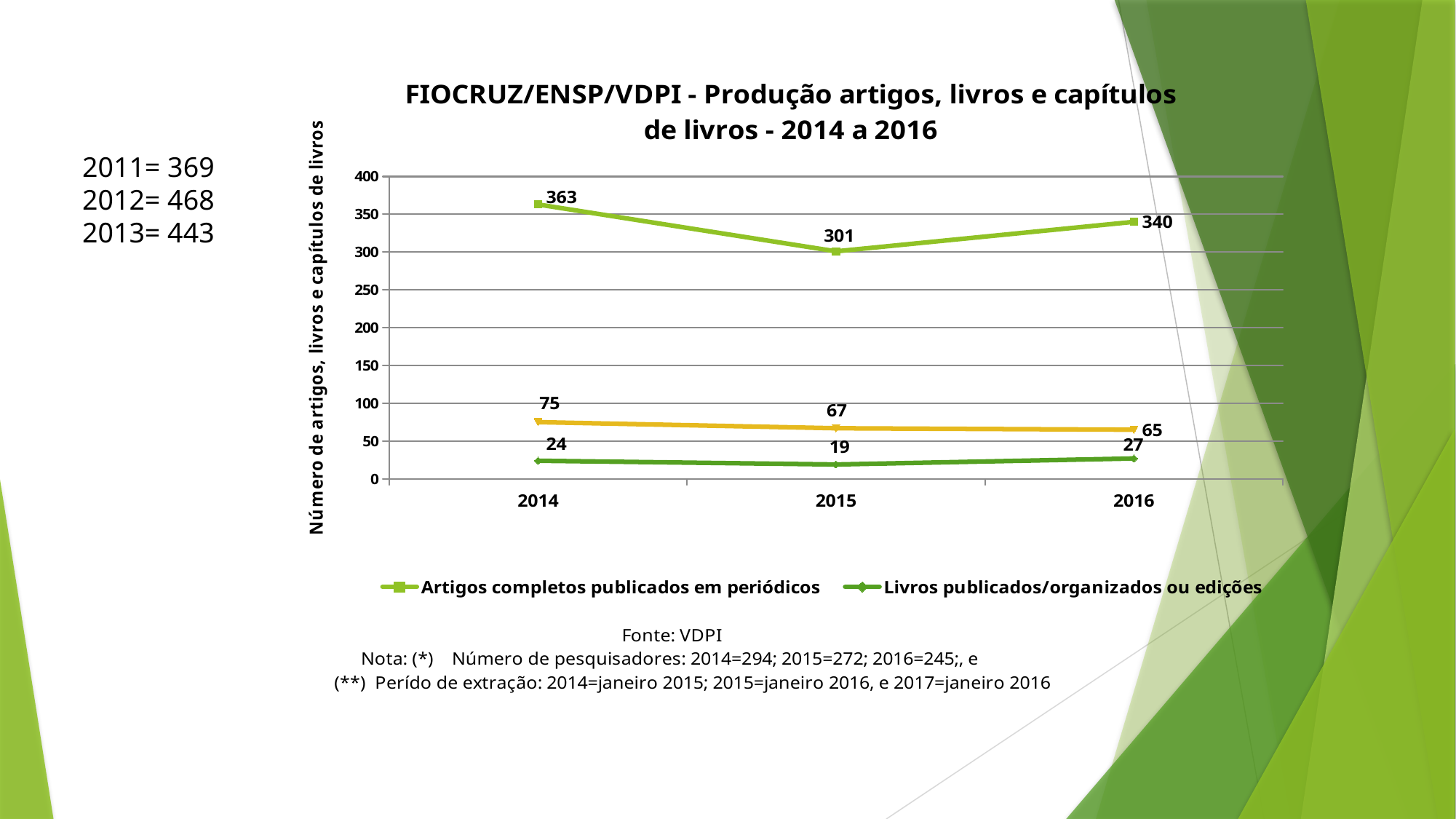
Does the value for Livros publicados/organizados ou edições rise or fall from 2014 to 2015? Fall How many series does the legend list? 2 How many years are shown on the x axis? 3 What is the value for Artigos completos publicados em periódicos in 2014? 363 Which year has the larger value for Artigos completos publicados em periódicos, 2014 or 2016? 2014 What is the difference between the 2014 and 2016 values for Artigos completos publicados em periódicos? 23 In which year is the value for Artigos completos publicados em periódicos lowest? 2015 What is the value for Artigos completos publicados em periódicos in 2015? 301 What is the label of the y axis? Número de artigos, livros e capítulos de livros In which year is the value for Livros publicados/organizados ou edições highest? 2016 What kind of chart is shown on the slide? Line chart What is the value for Livros publicados/organizados ou edições in 2016? 27